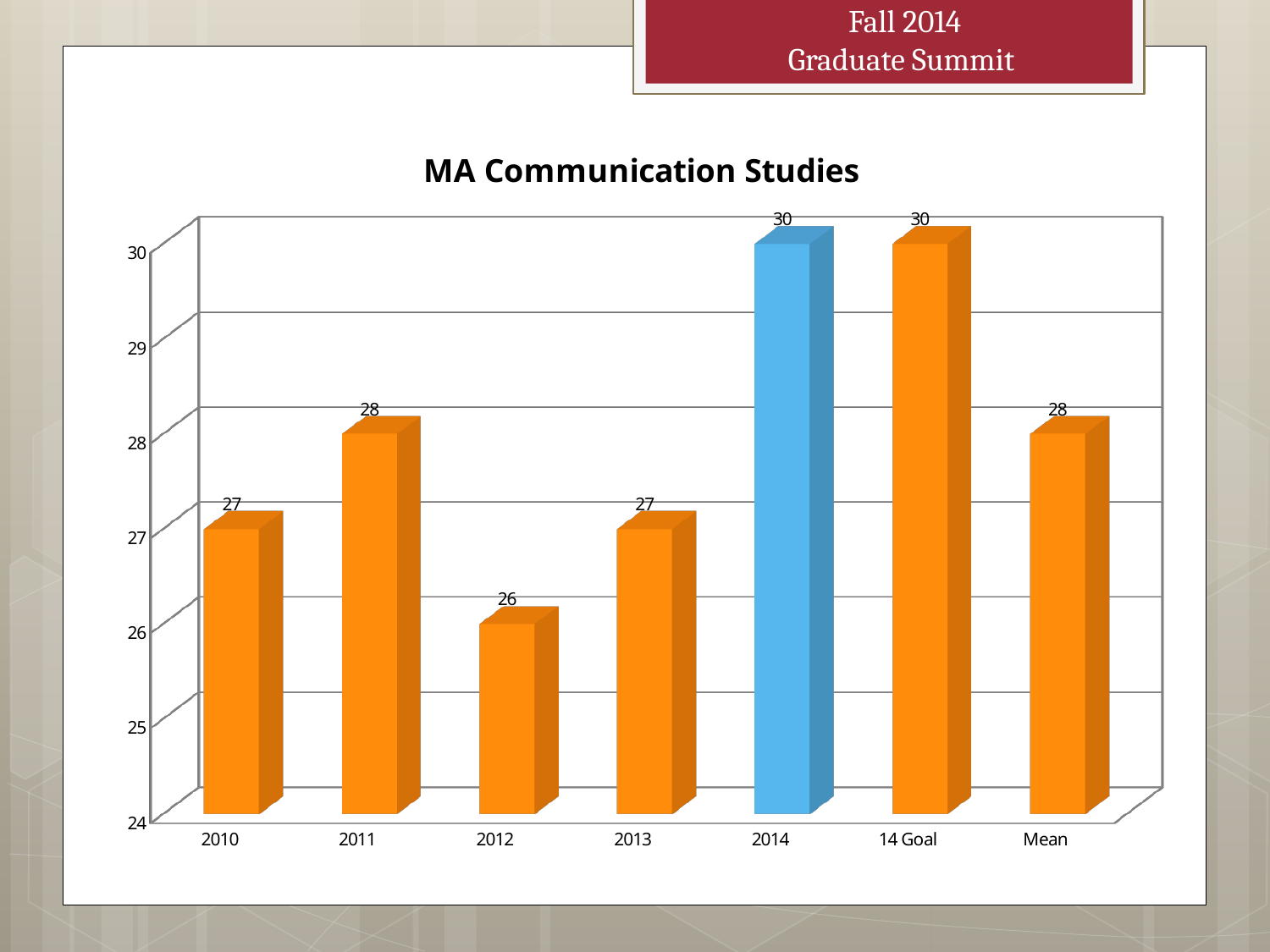
What is the value for Mean? 28 How many categories are shown on the x axis? 7 What is the value for 2012? 26 What is the title of the chart? MA Communication Studies Which is larger, the value for 2011 or the value for 2013? 2011 Which bar is coloured differently from the others? 2014 What is the difference between the values for 2014 and 2012? 4 What is the value for 14 Goal? 30 What is the difference between the values for 2011 and 2010? 1 What is the value for 2014? 30 Which category has the lowest value? 2012 What kind of chart is this? bar chart